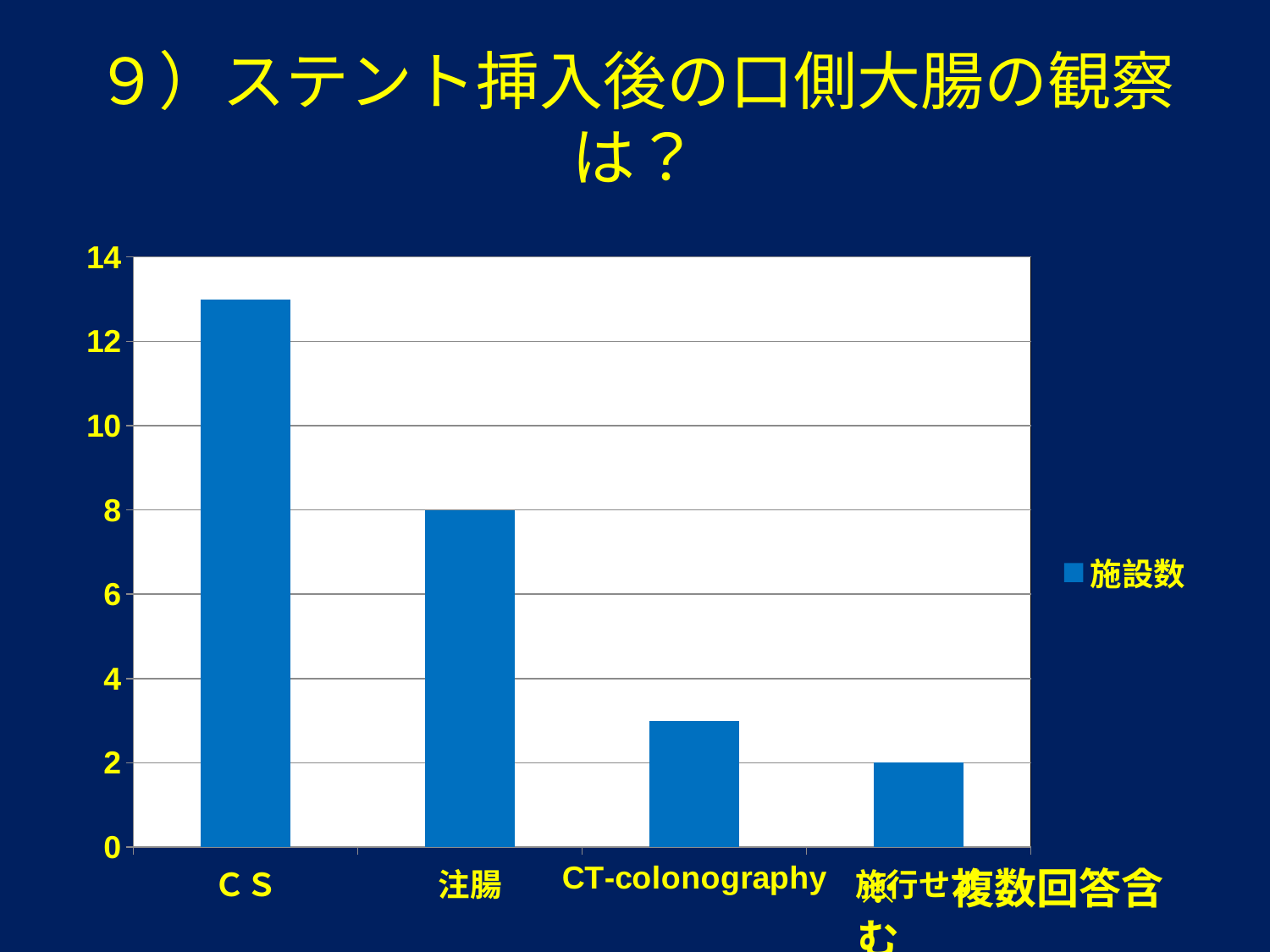
Do the values rise or fall from left to right along the x axis? fall How many categories are shown on the x axis of the chart? 4 Which category has the highest value? CS How many series does the chart's legend list? 1 What is the value for the rightmost bar (施行せず)? 2 Which is larger, the value for CS or the value for 注腸? CS Which category has the lowest value? 施行せず (the rightmost bar) What type of chart is shown on the slide? bar chart What is the name of the series shown in the legend? 施設数 Is the value for CS greater or less than 12? greater Is the value for CT-colonography greater or less than 4? less What is the value for 注腸? 8